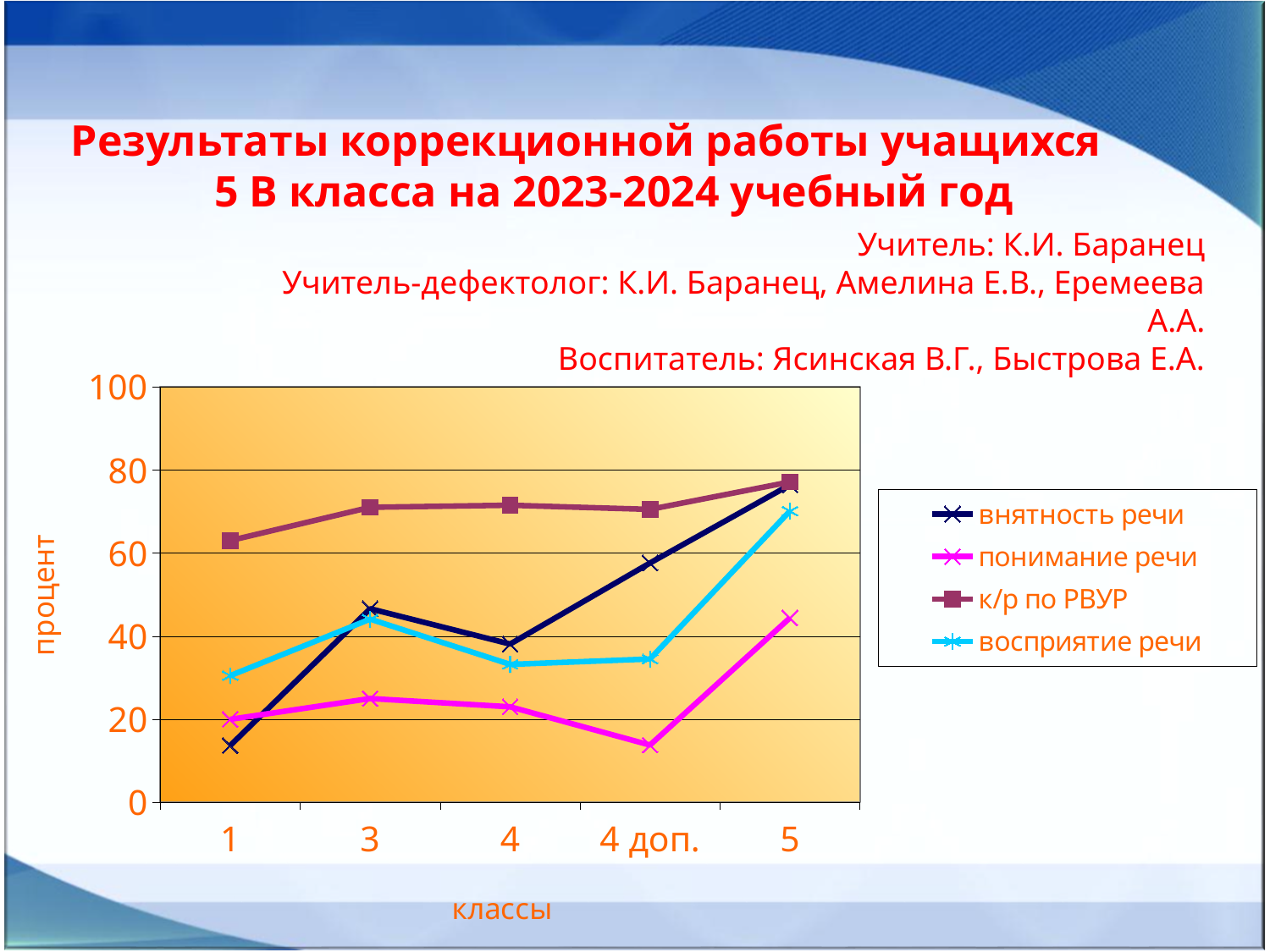
Which series has the lowest value at category 1? внятность речи Is the value for к/р по РВУР at category 3 greater or less than 60? greater How many categories are shown on the x axis? 5 Is the value for восприятие речи at category 5 greater or less than 60? greater What is the title of the vertical axis? процент At which category does понимание речи reach its lowest value? 4 доп. Which series has the highest value at category 1? к/р по РВУР How many series does the legend list? 4 At category 3, which is larger: внятность речи or понимание речи? внятность речи What kind of chart is shown on the slide? line chart Is the value for понимание речи at category 4 доп. greater or less than 20? less Does the к/р по РВУР series rise or fall overall from category 1 to category 5? rise